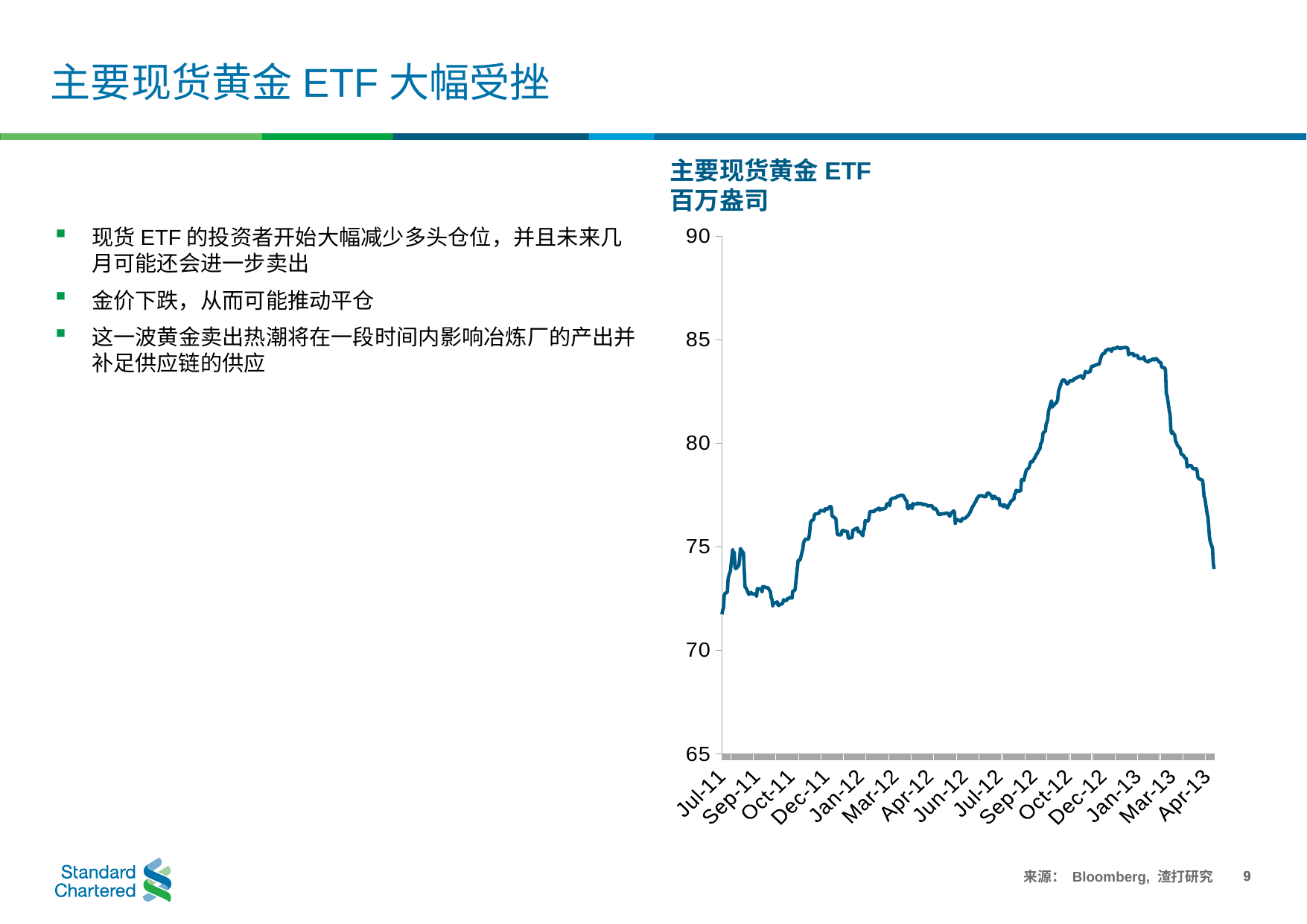
What is the lowest value shown on the y axis? 65 How many date labels are shown on the x axis? 15 Is the value at Mar-12 greater or less than 75? greater Is the value at Jul-11 greater or less than 75? less Is the value at Apr-13 greater or less than 80? less Does the line rise or fall between Sep-12 and Jan-13? rise What kind of chart is shown on the slide? line chart What is the title of the chart? 主要现货黄金 ETF What unit is stated under the chart title? 百万盎司 Does the line rise or fall between Mar-13 and Apr-13? fall Around which x-axis label does the line reach its highest point? Dec-12